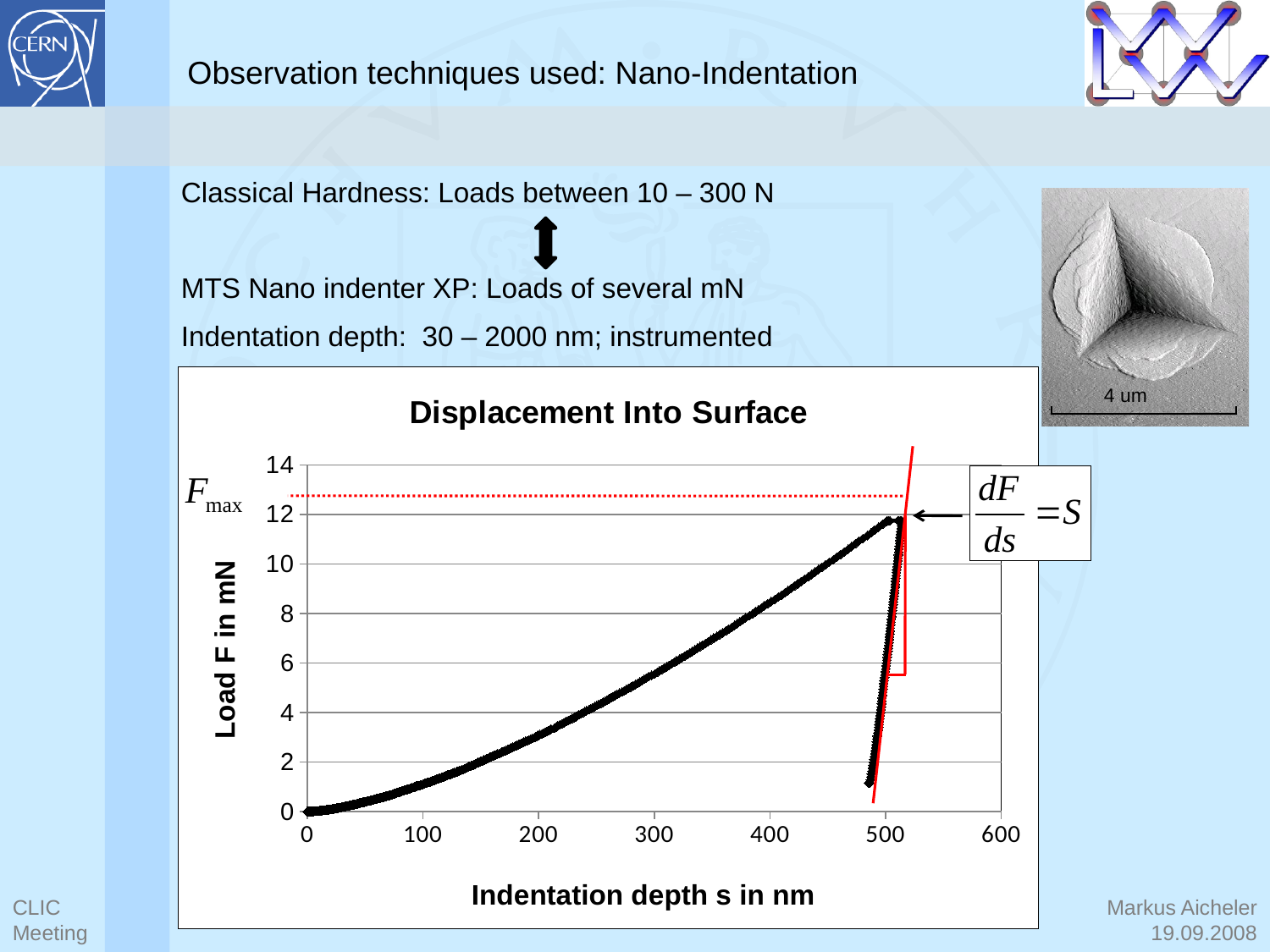
What is the highest value shown on the x axis of the chart? 600 Is the maximum load reached by the curve greater or less than 10 mN? greater What is the label of the vertical axis of the chart? Load F in mN What kind of chart is shown on the slide? line chart How many tick labels are shown on the x axis of the chart? 7 Is the load at an indentation depth of 100 nm greater or less than 2 mN? less During the loading part of the curve, does the load rise or fall as the indentation depth increases? rises Is the indentation depth at which the maximum load occurs greater or less than 400 nm? greater What is the title of the chart? Displacement Into Surface